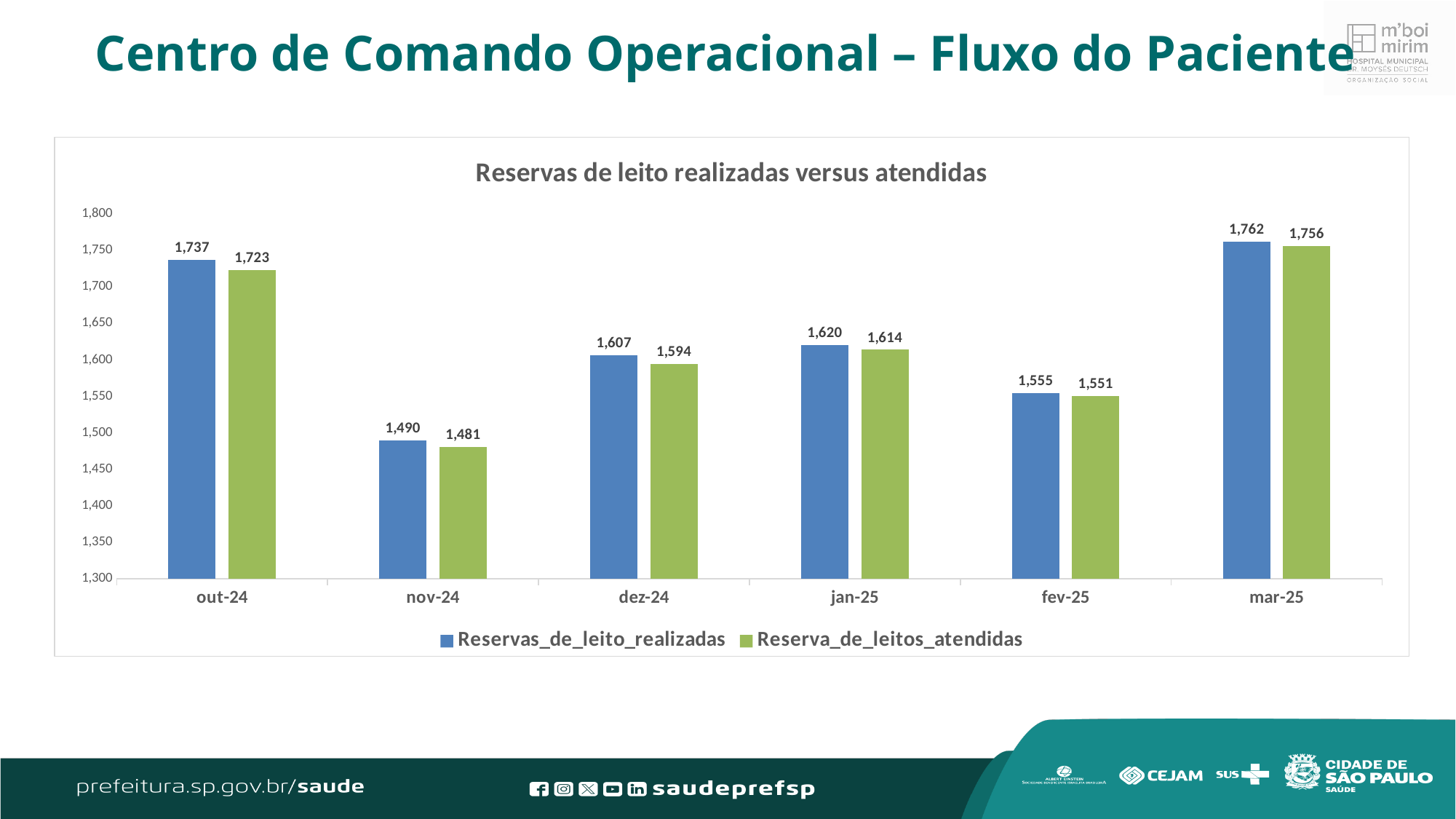
Which is larger: Reservas_de_leito_realizadas in fev-25 or Reservas_de_leito_realizadas in nov-24? fev-25 How many series does the legend list? 2 What is the value of Reservas_de_leito_realizadas for jan-25? 1,620 Which month has the lowest value for Reserva_de_leitos_atendidas? nov-24 Which month has the highest value for Reservas_de_leito_realizadas? mar-25 What kind of chart is shown? bar chart What is the value of Reserva_de_leitos_atendidas for nov-24? 1,481 What is the value of Reservas_de_leito_realizadas for out-24? 1,737 What is the title of the chart? Reservas de leito realizadas versus atendidas What is the difference between Reservas_de_leito_realizadas and Reserva_de_leitos_atendidas in dez-24? 13 Is the value of Reserva_de_leitos_atendidas for mar-25 greater or less than 1,700? greater How many months are shown on the x axis? 6